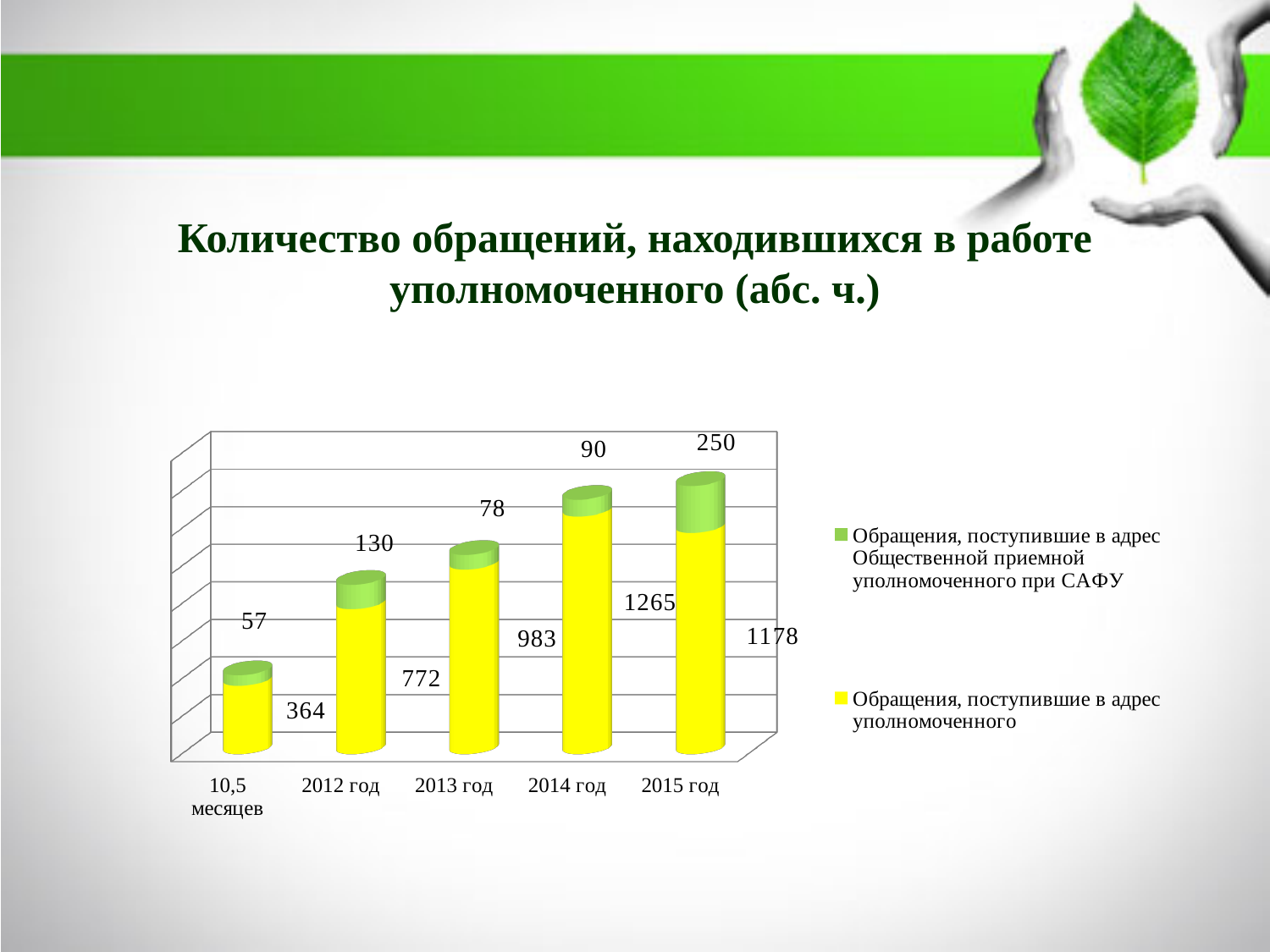
What is the value of "Обращения, поступившие в адрес Общественной приемной уполномоченного при САФУ" for 2015 год? 250 How many categories are shown on the x axis? 5 What colour represents "Обращения, поступившие в адрес уполномоченного" in the chart? yellow What is the total of the stacked bar for 2015 год? 1428 Which category has the lowest value for "Обращения, поступившие в адрес Общественной приемной уполномоченного при САФУ"? 10,5 месяцев Which category has the highest value for "Обращения, поступившие в адрес уполномоченного"? 2014 год What is the value of "Обращения, поступившие в адрес уполномоченного" for 10,5 месяцев? 364 What is the value of "Обращения, поступившие в адрес уполномоченного" for 2014 год? 1265 What is the difference between the "Обращения, поступившие в адрес уполномоченного" values for 2014 год and 2015 год? 87 Which is larger: the "Обращения, поступившие в адрес Общественной приемной уполномоченного при САФУ" value for 2012 год or for 2013 год? 2012 год How many series does the legend list? 2 What type of chart is shown on the slide? bar chart